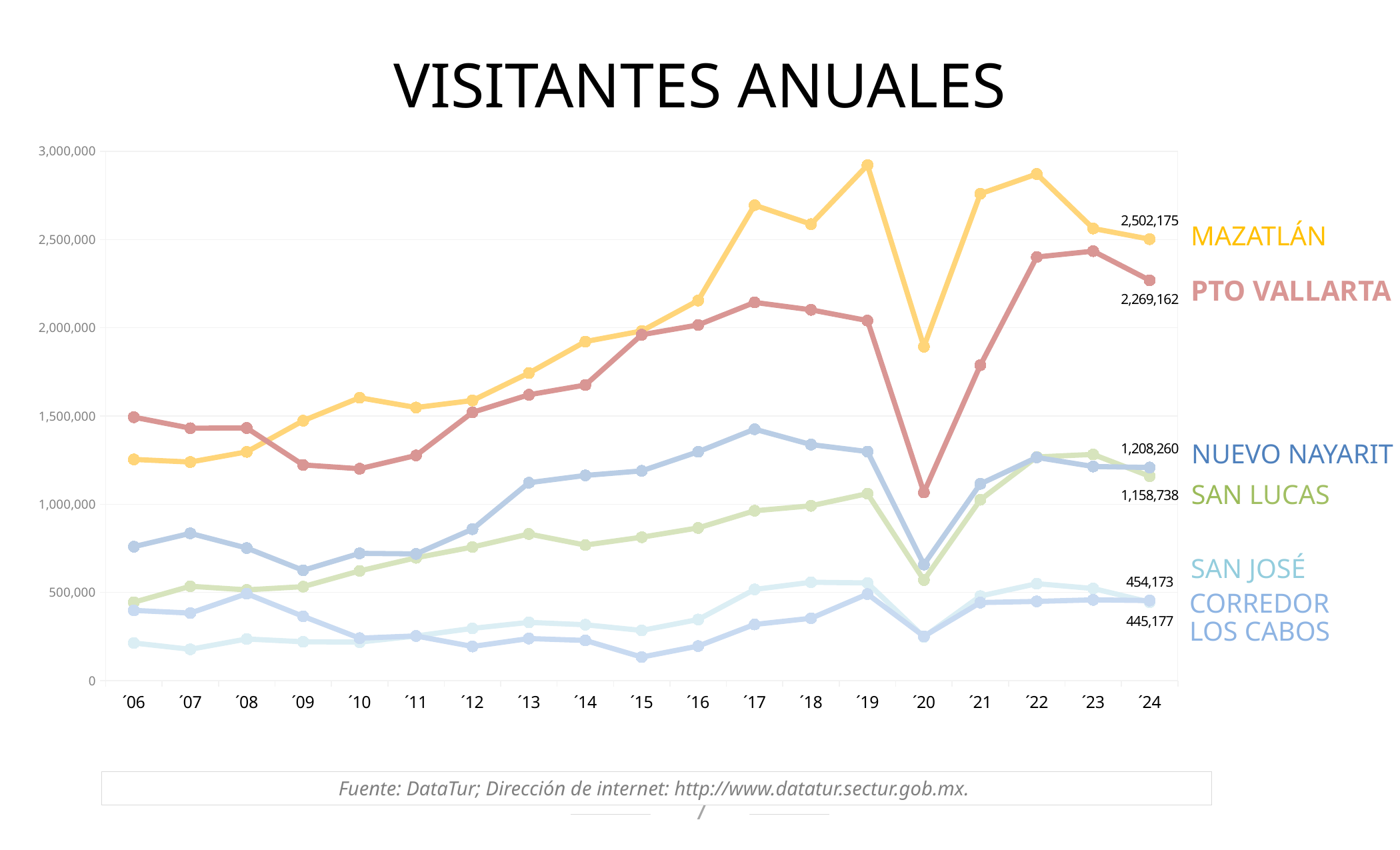
What kind of chart is shown on the slide? line chart What is the title of the chart? VISITANTES ANUALES Is the value for MAZATLÁN in '19 greater or less than 2,500,000? greater How many destinations (series) are plotted on the chart? 6 What is the value for MAZATLÁN in '24? 2,502,175 Which destination has the highest value in '24? MAZATLÁN How many years are shown on the x axis? 19 What is the value for PTO VALLARTA in '24? 2,269,162 What is the value for NUEVO NAYARIT in '24? 1,208,260 What is the difference between the '24 values for SAN JOSÉ and CORREDOR LOS CABOS? 8,996 What is the value for SAN LUCAS in '24? 1,158,738 What is the difference between the '24 values for MAZATLÁN and PTO VALLARTA? 233,013